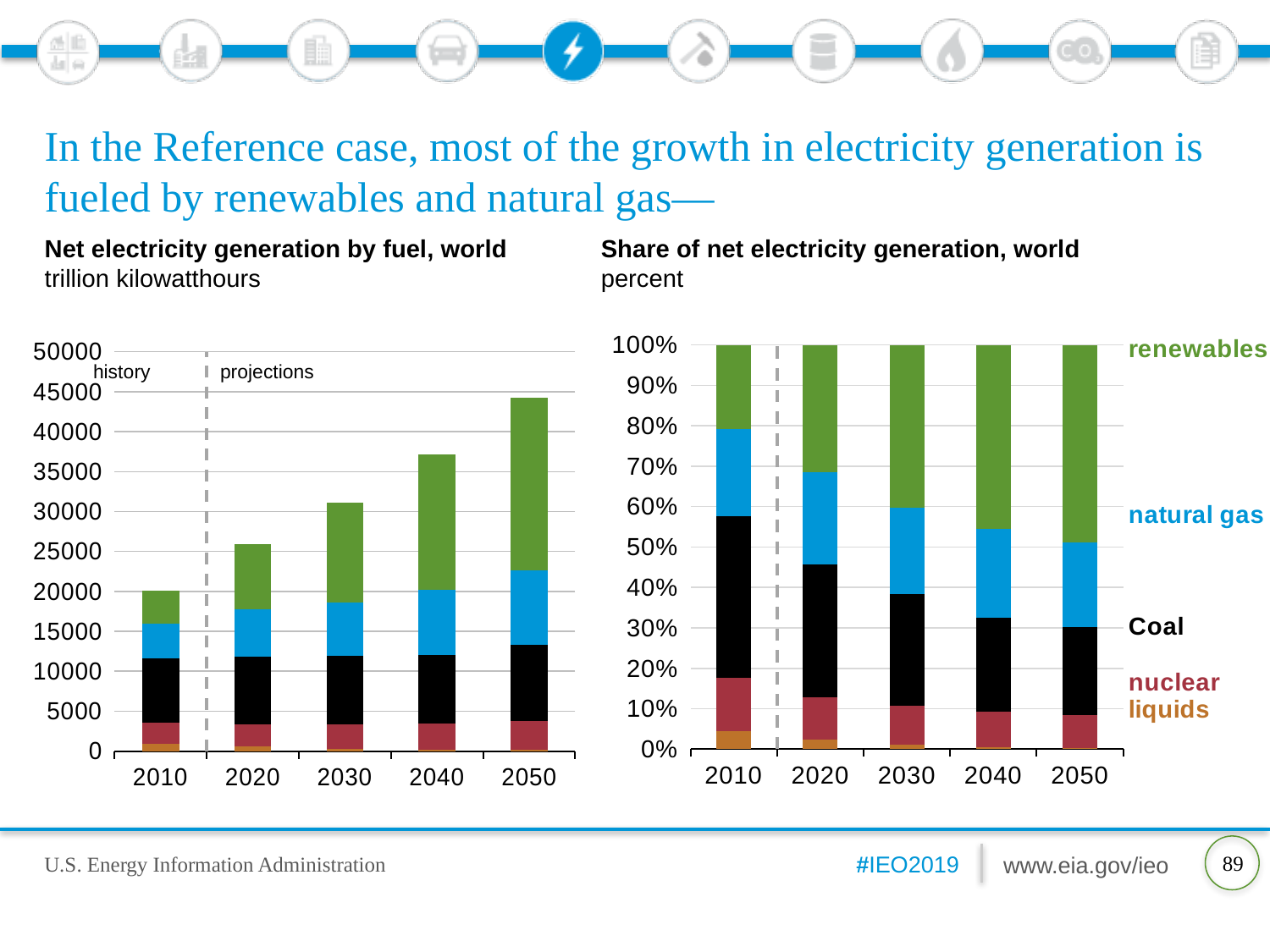
What kind of chart is the left chart, 'Net electricity generation by fuel, world'? stacked bar chart What unit is given under the title of the left chart, 'Net electricity generation by fuel, world'? trillion kilowatthours How many fuel categories does the right chart, 'Share of net electricity generation, world', label? 5 In the left chart, 'Net electricity generation by fuel, world', which year has the lowest total net electricity generation? 2010 In the right chart, 'Share of net electricity generation, world', is the share of renewables in 2050 greater or less than 40%? greater In the left chart, 'Net electricity generation by fuel, world', which year has the highest total net electricity generation? 2050 In the right chart, 'Share of net electricity generation, world', does the share of Coal rise or fall from 2010 to 2050? fall In the left chart, 'Net electricity generation by fuel, world', is the total for 2050 greater or less than 40000? greater In the left chart, 'Net electricity generation by fuel, world', does total net electricity generation rise or fall from 2010 to 2050? rise How many years are shown on the x axis of the left chart, 'Net electricity generation by fuel, world'? 5 In the left chart, 'Net electricity generation by fuel, world', is the total for 2020 greater or less than 30000? less In the right chart, 'Share of net electricity generation, world', which is larger in 2010: the share of Coal or the share of natural gas? Coal